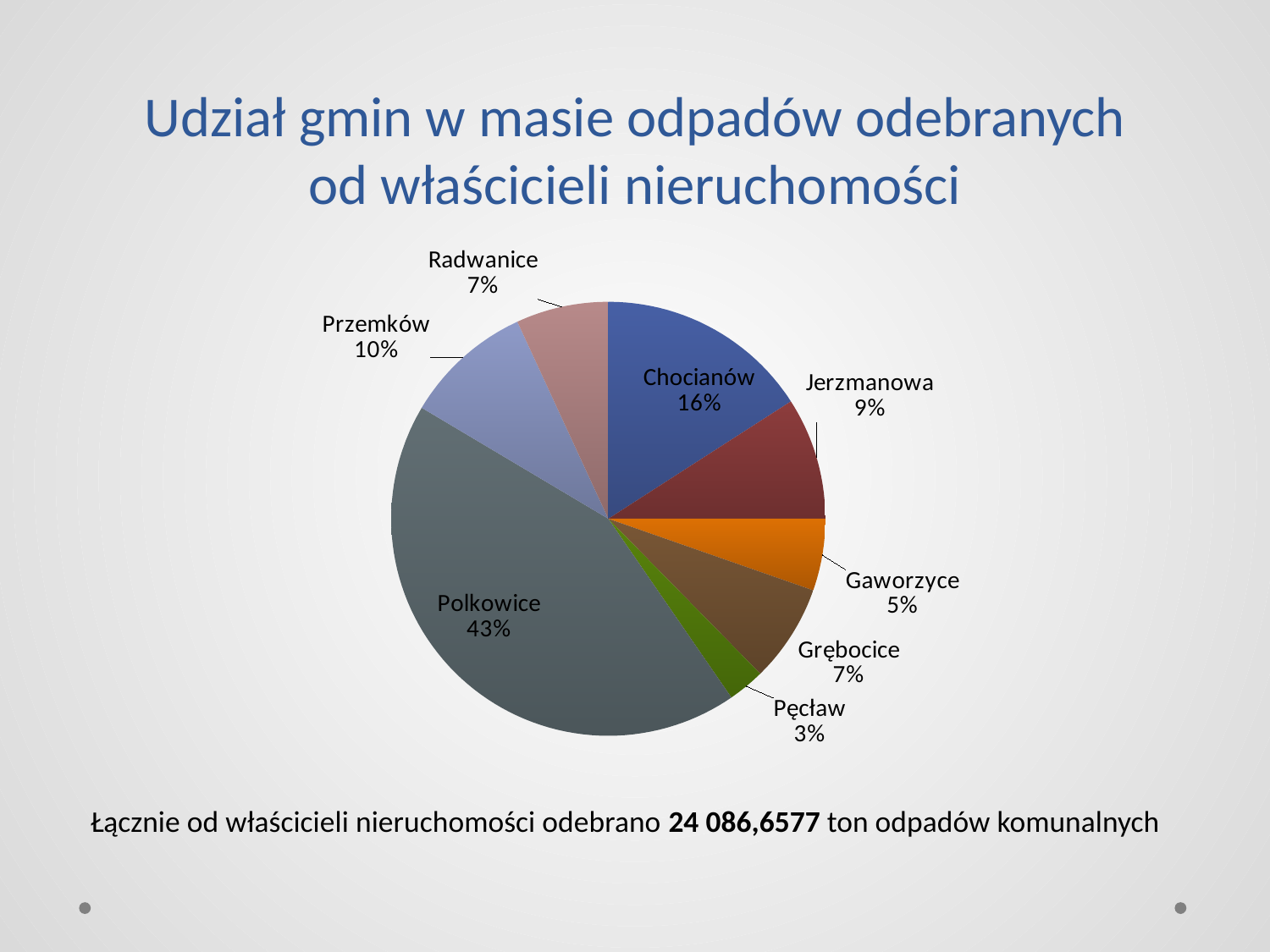
What is the value shown for Przemków? 10% What is the value shown for Jerzmanowa? 9% How many slices does the pie chart have? 8 Which municipality has the largest slice of the pie? Polkowice What share of the pie does Polkowice have? 43% Which is larger, the share for Jerzmanowa or the share for Gaworzyce? Jerzmanowa What is the title of the chart on the slide? Udział gmin w masie odpadów odebranych od właścicieli nieruchomości What is the value shown for Pęcław? 3% What share of the pie does Chocianów have? 16% What kind of chart is shown on the slide? pie chart Which municipality has the smallest slice of the pie? Pęcław What is the difference in percentage points between Polkowice and Chocianów? 27